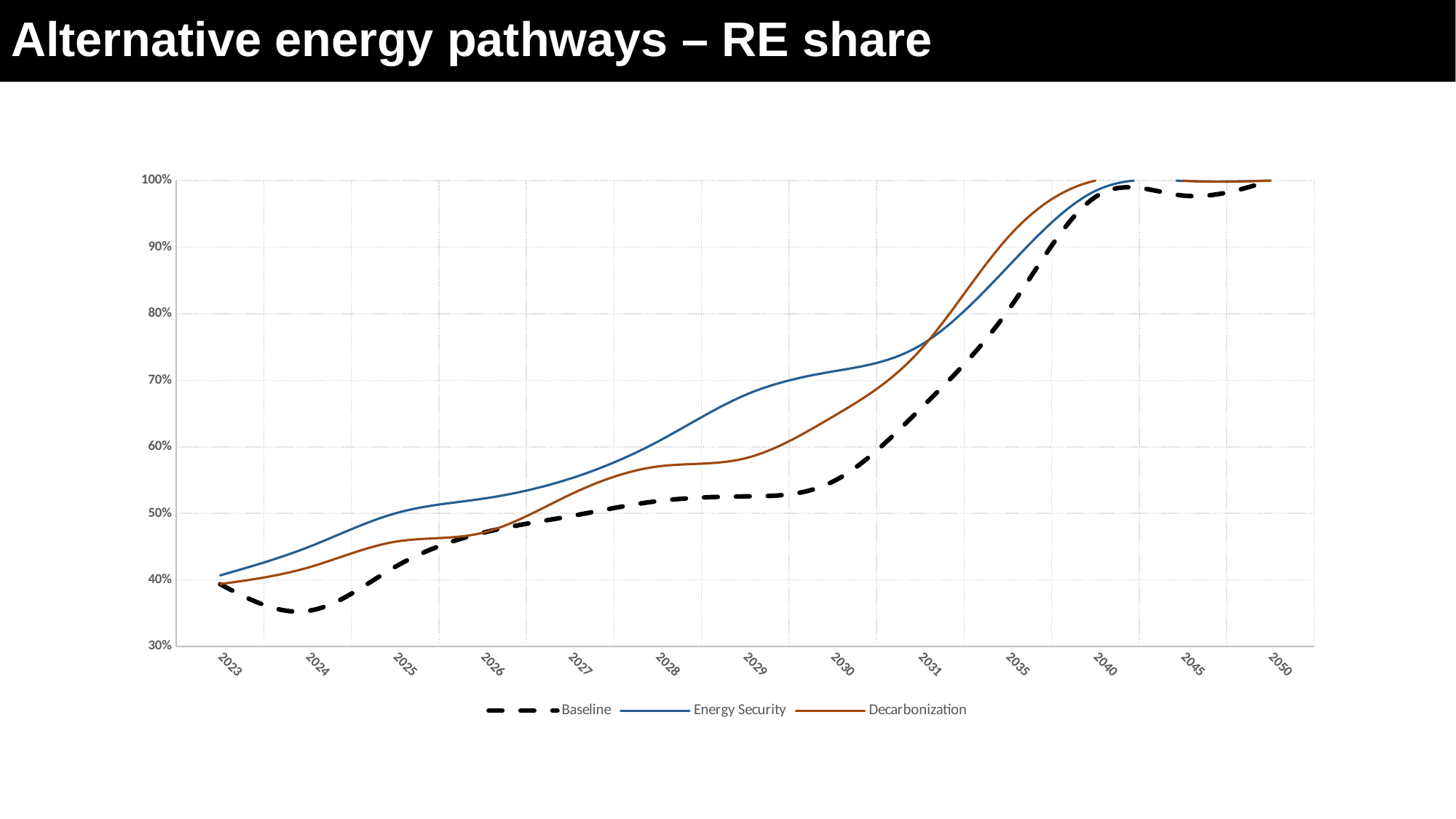
Is the Decarbonization value in 2035 greater or less than 90%? greater Is the Baseline value in 2035 greater or less than 90%? less In 2024, which series has the higher value, Baseline or Energy Security? Energy Security What kind of chart is shown on the slide? line chart In 2029, which series has the higher value, Energy Security or Decarbonization? Energy Security How many series does the legend list? 3 How many years are labelled on the x axis? 13 Does the Energy Security series rise or fall from 2023 to 2040? rise Is the Energy Security value in 2029 greater or less than 60%? greater In which year does the Baseline series reach its lowest value? 2024 What is the RE share for Energy Security in 2050? 100%